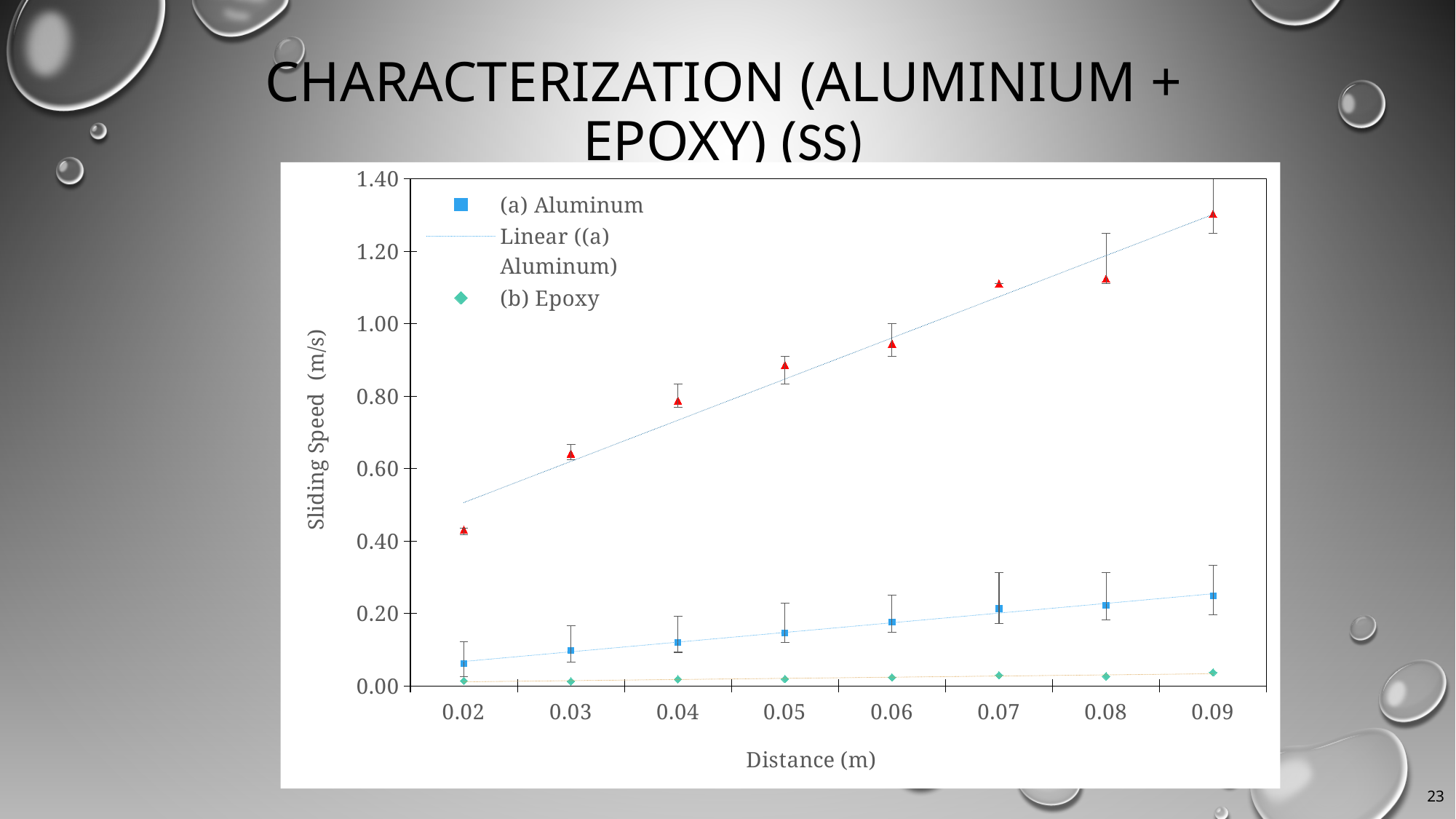
Is the red triangle series value at 0.02 m greater or less than 0.20 m/s? greater At which distance is the (a) Aluminum sliding speed highest? 0.09 How many distance values are marked along the x axis? 8 Is the (b) Epoxy sliding speed at 0.09 m greater or less than 0.20 m/s? less How many series does the legend list? 3 Is the red triangle series value at 0.09 m greater or less than 1.20 m/s? greater What kind of chart is shown on the slide? scatter chart Do the (a) Aluminum values rise or fall as distance increases? rise At 0.09 m, which series has the larger sliding speed, (a) Aluminum or (b) Epoxy? (a) Aluminum What is the label of the y axis? Sliding Speed (m/s) At which distance is the (a) Aluminum sliding speed lowest? 0.02